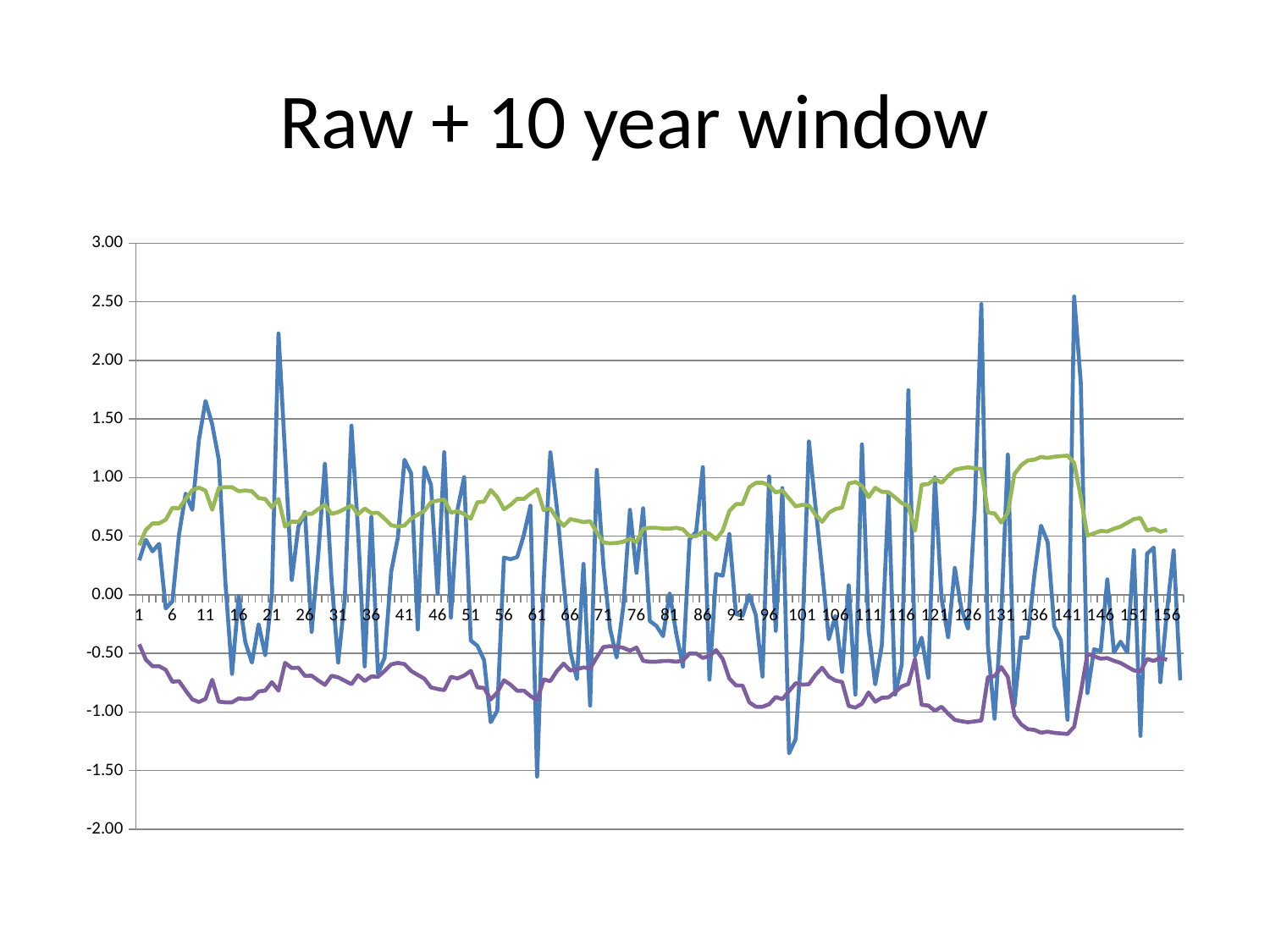
Is the value of the green line at x = 11 greater or less than 0.50? greater What is the lowest value shown on the y axis? -2.00 Is the value of the purple line at x = 141 greater or less than -1.00? less Is the value of the blue line at x = 61 greater or less than -1.00? less What kind of chart is shown on the slide? line chart What is the last label on the x axis? 156 What is the highest value shown on the y axis? 3.00 Does the green line rise or fall between x = 141 and x = 146? fall What is the title of the chart? Raw + 10 year window At x = 61, which line has the lowest value: blue, green or purple? blue How many lines are plotted on the chart? 3